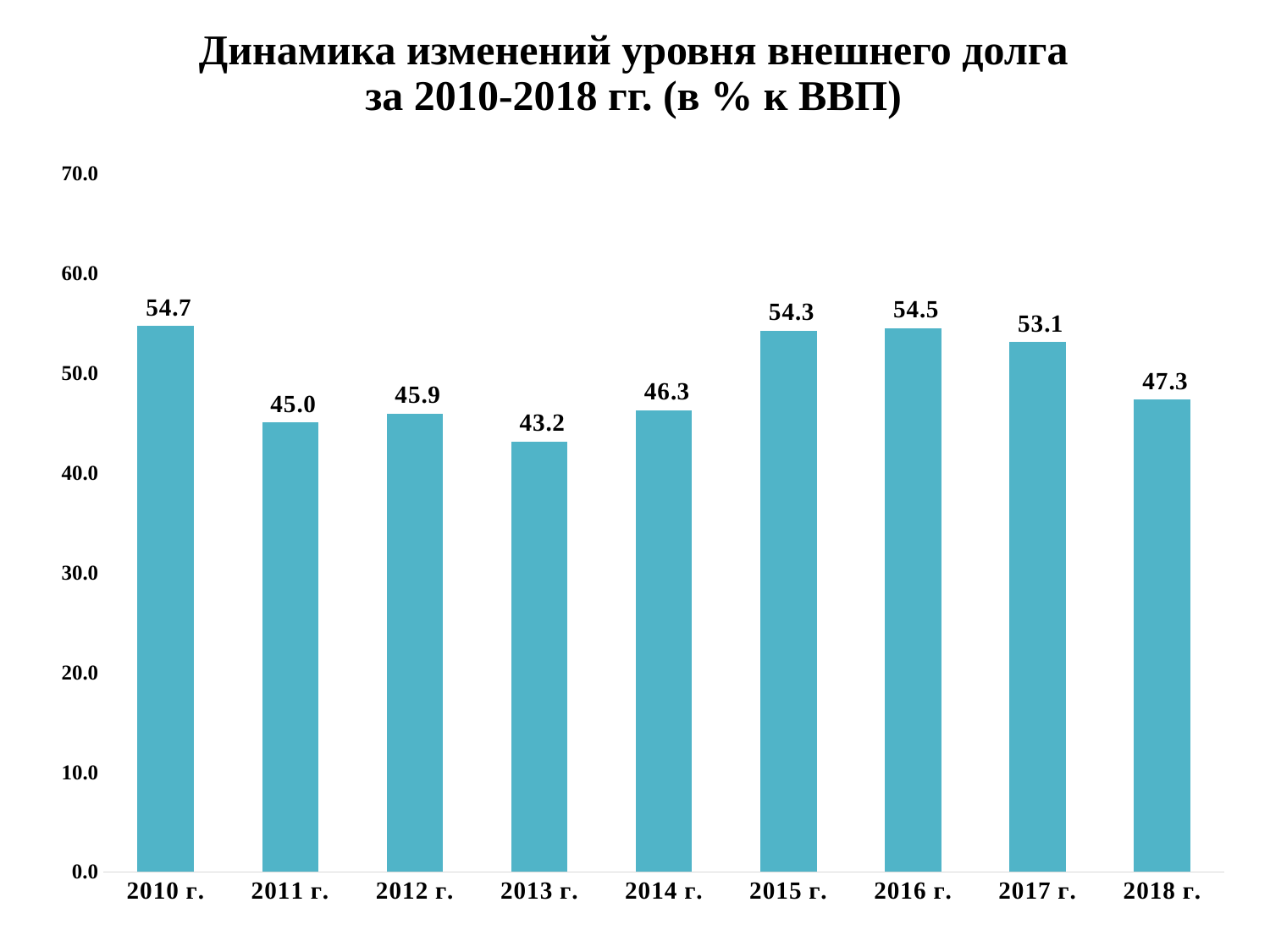
What is the value shown for 2018 г.? 47.3 What is the difference between the values for 2016 г. and 2017 г.? 1.4 What kind of chart is shown on the slide? bar chart What is the value shown for 2013 г.? 43.2 Which is larger, the value for 2012 г. or the value for 2014 г.? 2014 г. What is the difference between the values for 2010 г. and 2013 г.? 11.5 How many years are shown on the chart? 9 Do the values rise or fall from 2016 г. to 2018 г.? fall Is the value for 2015 г. greater or less than 50.0? greater Which year has the highest external debt level? 2010 г. What is the external debt level for 2010 г.? 54.7 Which year has the lowest external debt level? 2013 г.